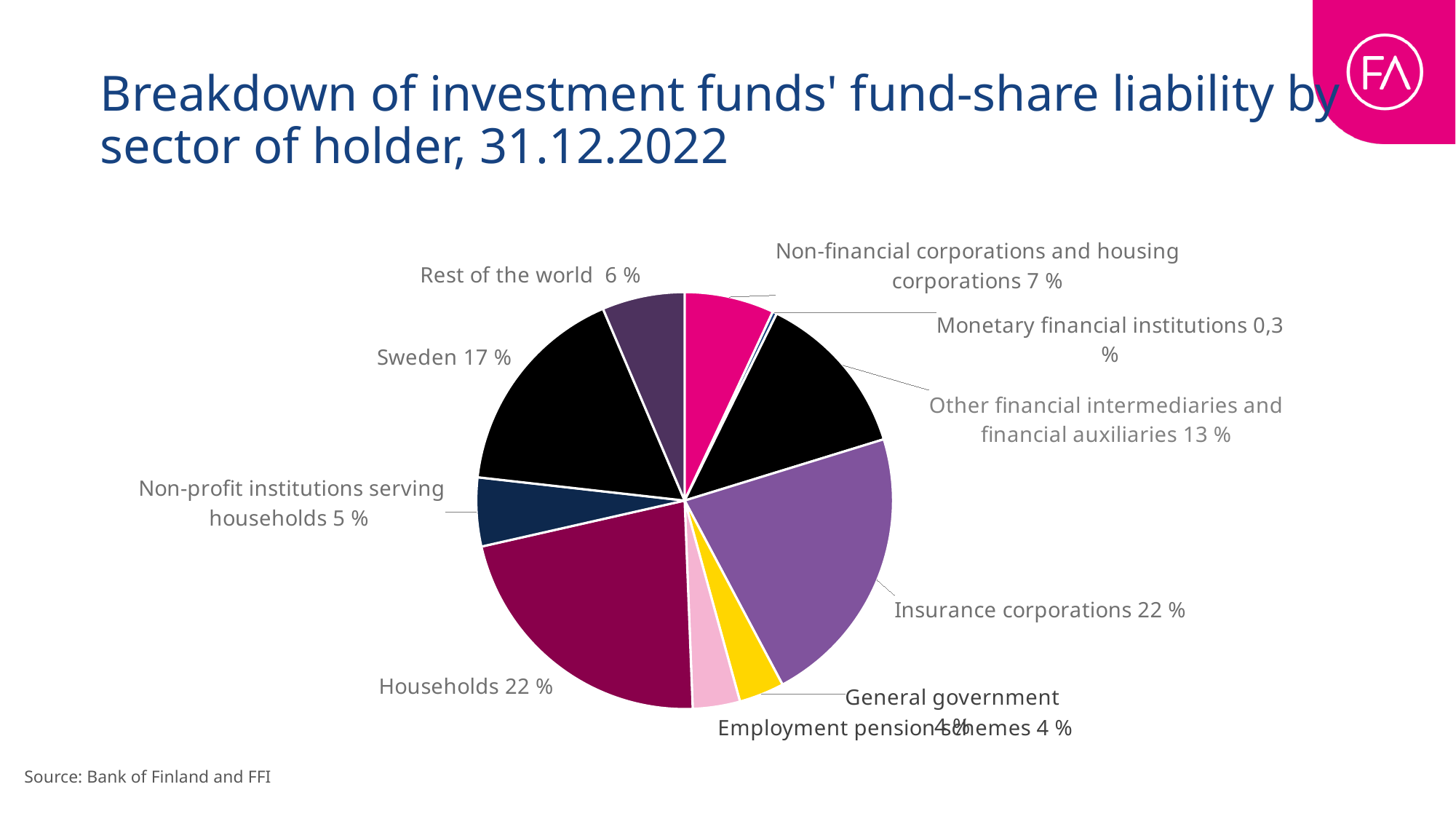
What share is held by Other financial intermediaries and financial auxiliaries? 13 % What share is held by Monetary financial institutions? 0,3 % How many sectors are shown in the pie chart? 10 What share is held by Employment pension schemes? 4 % What is the source cited for the chart? Bank of Finland and FFI What share of the fund-share liability is held by Sweden? 17 % What kind of chart is shown on the slide? Pie chart What share is held by Rest of the world? 6 % What share is held by Non-profit institutions serving households? 5 % How many percentage points larger is Sweden's share than that of Non-financial corporations and housing corporations? 10 Which holds a larger share: Sweden or Other financial intermediaries and financial auxiliaries? Sweden Which sector holds the smallest share of the fund-share liability? Monetary financial institutions